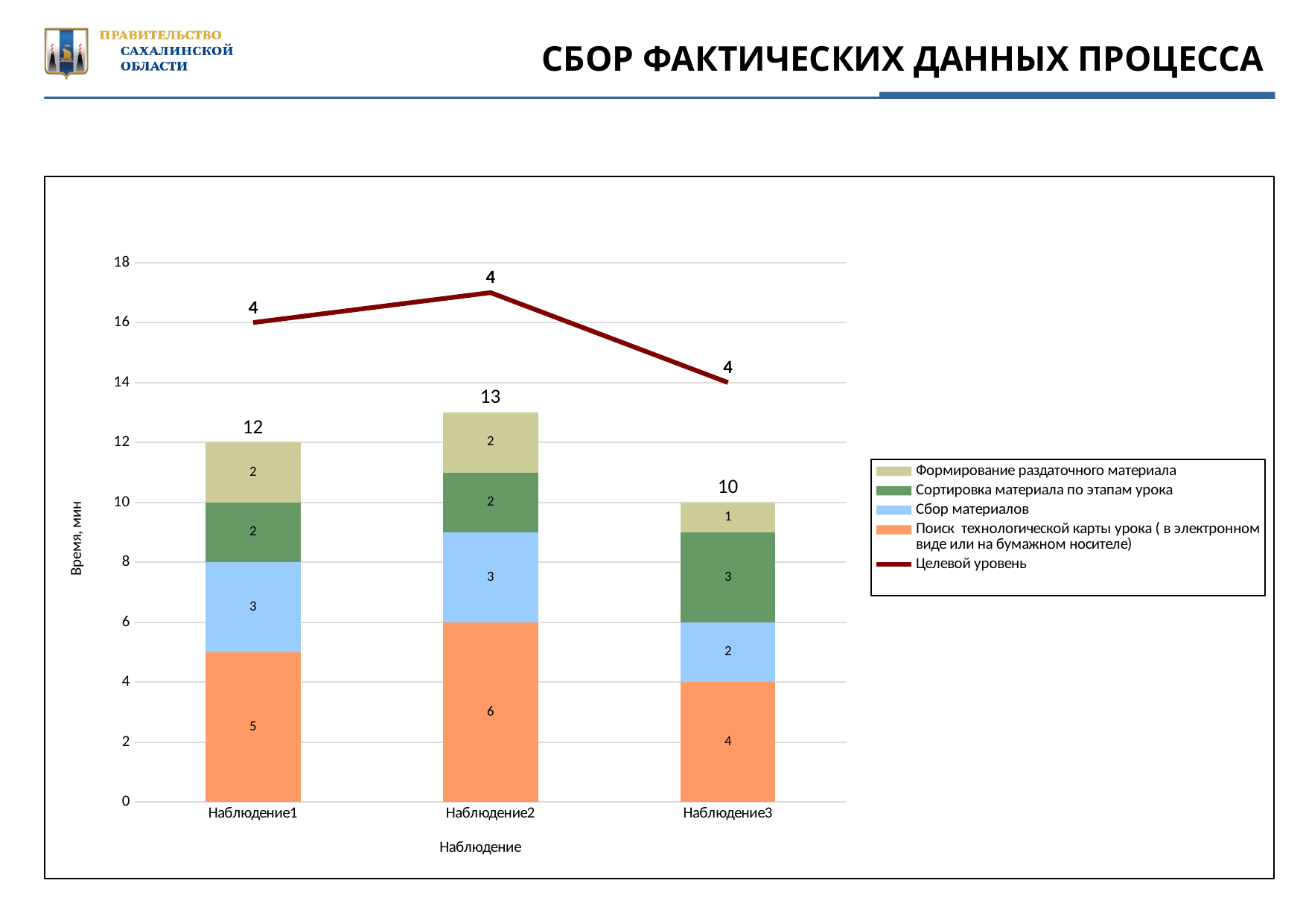
Which is larger: Поиск технологической карты урока for Наблюдение1 or for Наблюдение3? Наблюдение1 What is the label of the y axis? Время, мин What is the value of Поиск технологической карты урока for Наблюдение1? 5 How many series does the legend list? 5 How many observations (categories) are shown on the x axis? 3 What is the total of the stacked bar for Наблюдение2? 13 What is the difference between the stacked bar totals for Наблюдение2 and Наблюдение3? 3 What is the value of Формирование раздаточного материала for Наблюдение2? 2 Which observation has the highest stacked bar total? Наблюдение2 What is the value of Сортировка материала по этапам урока for Наблюдение3? 3 What is the value of Сбор материалов for Наблюдение3? 2 Which observation has the lowest stacked bar total? Наблюдение3